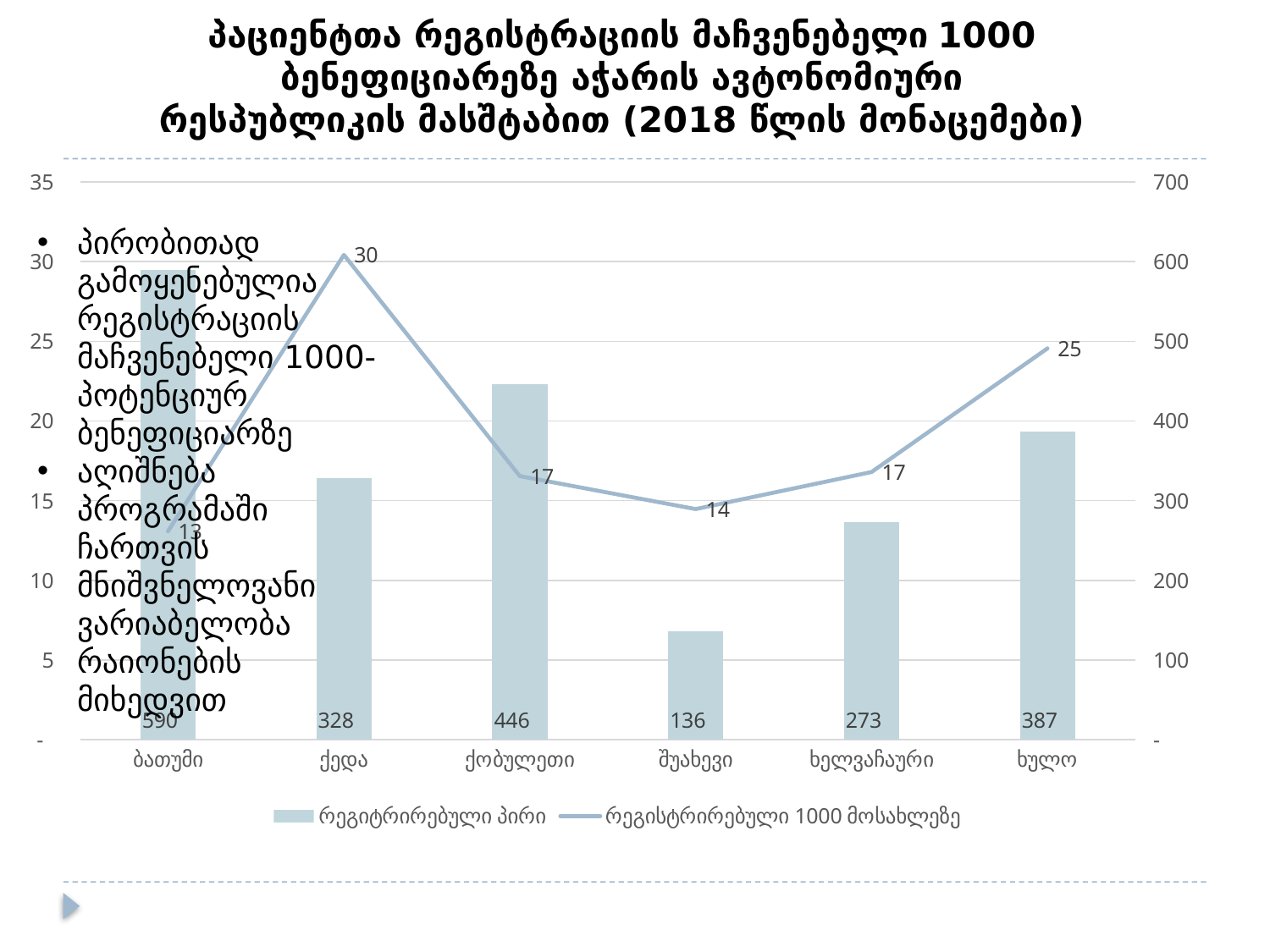
What is the difference between the რეგიტრირებული პირი values for ხულო and ხელვაჩაური? 114 What is the value of რეგიტრირებული პირი for ქობულეთი? 446 Which is larger, the რეგიტრირებული პირი value for ქედა or for ხულო? ხულო What is the value of რეგისტრირებული 1000 მოსახლეზე for ხულო? 25 What is the value of რეგისტრირებული 1000 მოსახლეზე for ქედა? 30 How many series does the legend list? 2 Which category has the highest value of რეგისტრირებული 1000 მოსახლეზე? ქედა Which category has the highest value of რეგიტრირებული პირი? ბათუმი What is the difference between the რეგისტრირებული 1000 მოსახლეზე values for ქედა and შუახევი? 16 What is the value of რეგიტრირებული პირი for შუახევი? 136 How many categories are shown on the x axis? 6 Which category has the lowest value of რეგიტრირებული პირი? შუახევი